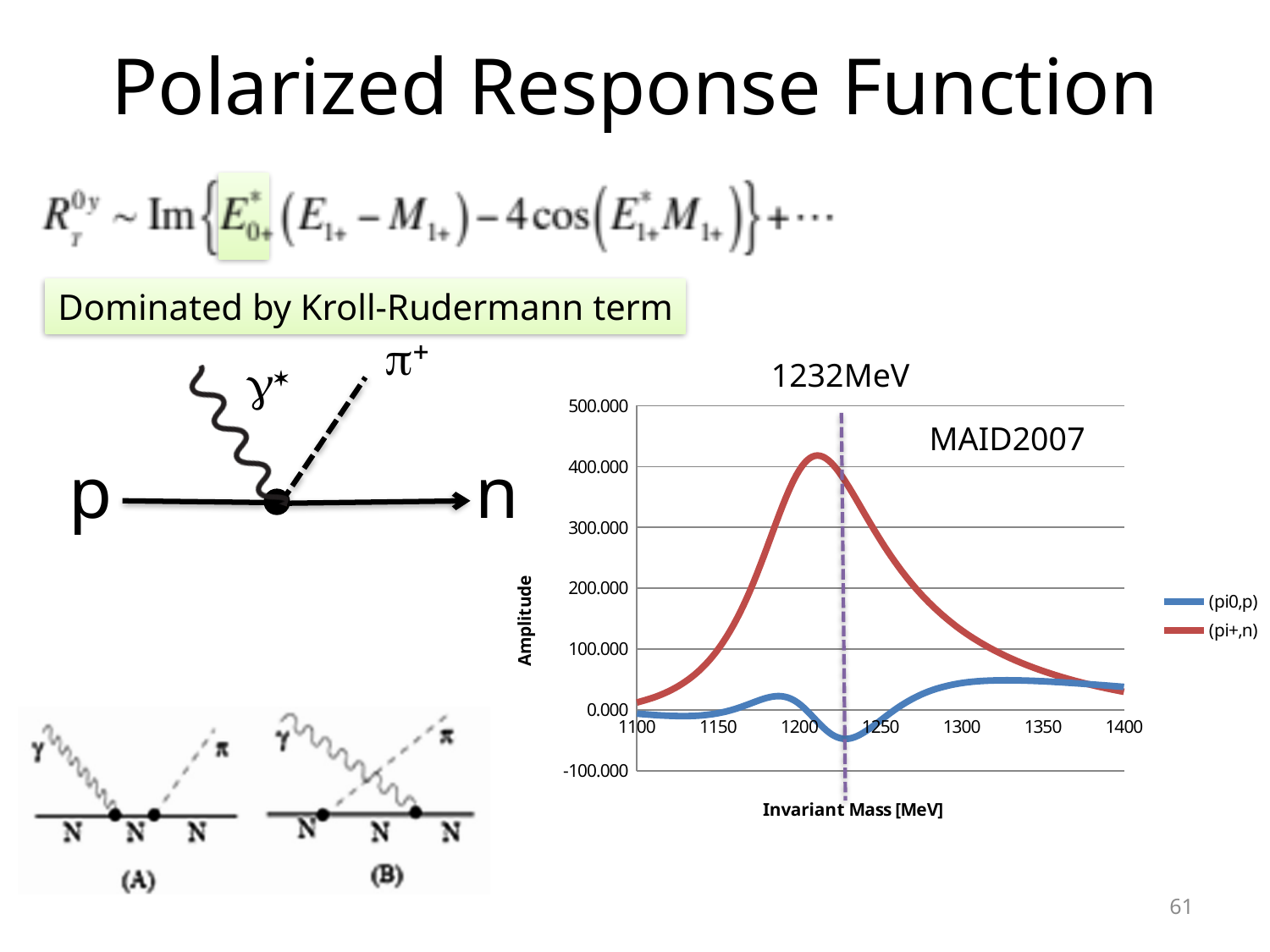
Which series reaches the higher peak amplitude, (pi0,p) or (pi+,n)? (pi+,n) What are the two series named in the chart legend? (pi0,p) and (pi+,n) Does the (pi+,n) series rise or fall between 1100 MeV and 1200 MeV? rise Does the (pi+,n) series rise or fall between 1250 MeV and 1400 MeV? fall What is the lowest value shown on the y axis of the chart? -100.000 At an invariant mass of 1200 MeV, which series has the larger amplitude, (pi0,p) or (pi+,n)? (pi+,n) How many series does the chart legend list? 2 At an invariant mass of 1400 MeV, is the amplitude of the (pi+,n) series greater or less than 100.000? less Is the maximum amplitude of the (pi0,p) series greater or less than 100.000? less At an invariant mass of 1200 MeV, is the amplitude of the (pi+,n) series greater or less than 300.000? greater What type of chart is shown on the slide? line chart What is the label of the x axis of the chart? Invariant Mass [MeV]